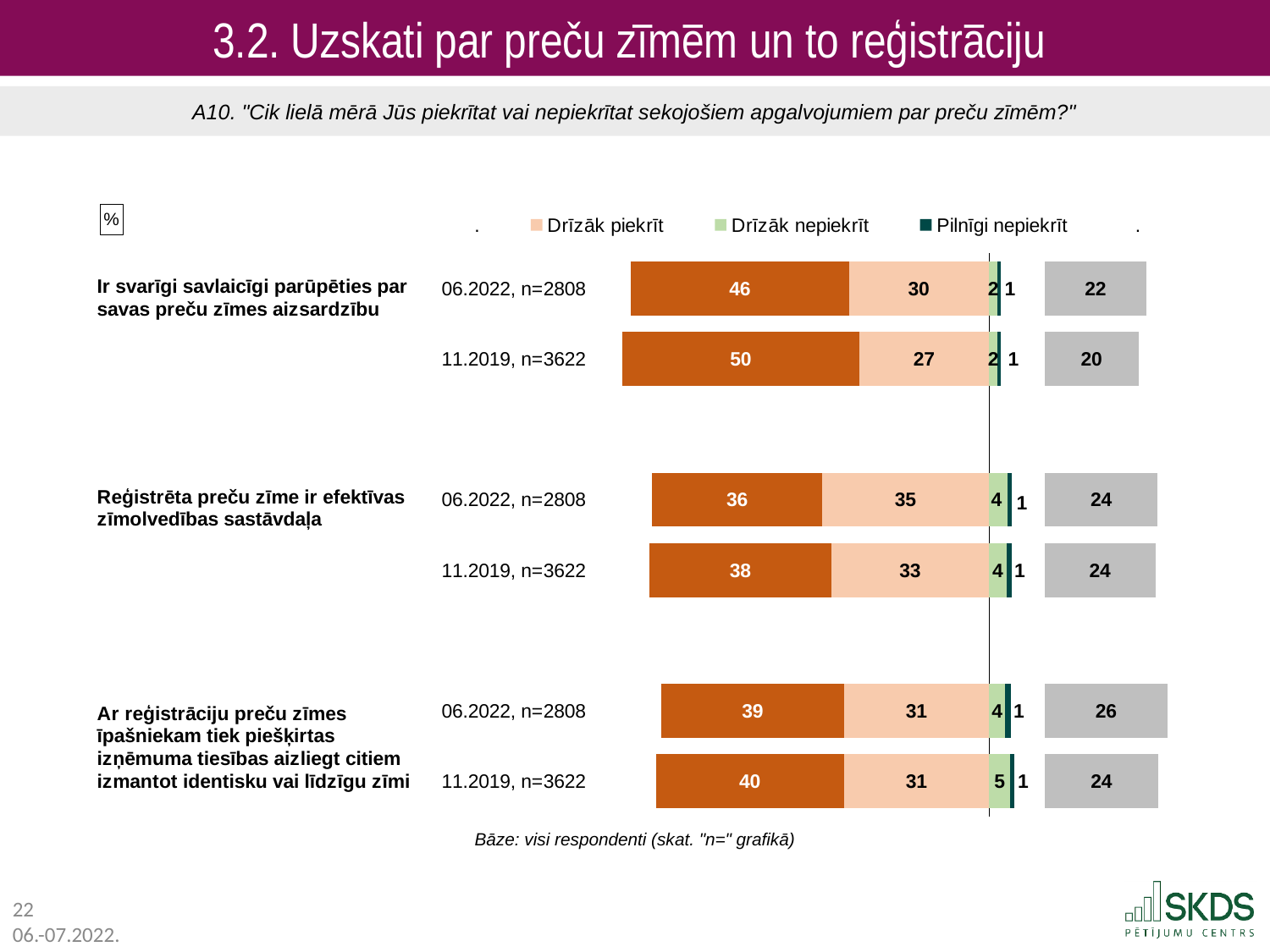
What is the value of the grey segment for "Ar reģistrāciju preču zīmes īpašniekam tiek piešķirtas izņēmuma tiesības aizliegt citiem izmantot identisku vai līdzīgu zīmi" in 06.2022, n=2808? 26 What type of chart is shown on the slide? Stacked bar chart What is the "Drīzāk piekrīt" value for "Ir svarīgi savlaicīgi parūpēties par savas preču zīmes aizsardzību" in 06.2022, n=2808? 30 How many stacked bars are shown in the chart? 6 For "Reģistrēta preču zīme ir efektīvas zīmolvedības sastāvdaļa", what is the difference between the "Drīzāk piekrīt" values in 06.2022 and 11.2019? 2 What is the "Drīzāk nepiekrīt" value for "Ar reģistrāciju preču zīmes īpašniekam tiek piešķirtas izņēmuma tiesības aizliegt citiem izmantot identisku vai līdzīgu zīmi" in 11.2019, n=3622? 5 Among the 06.2022, n=2808 bars, which statement has the highest "Drīzāk piekrīt" value? Reģistrēta preču zīme ir efektīvas zīmolvedības sastāvdaļa What is the "Drīzāk piekrīt" value for "Reģistrēta preču zīme ir efektīvas zīmolvedības sastāvdaļa" in 11.2019, n=3622? 33 What is the total of all segments in the bar for "Reģistrēta preču zīme ir efektīvas zīmolvedības sastāvdaļa" in 06.2022, n=2808? 100 Among the 11.2019, n=3622 bars, which statement has the lowest "Drīzāk nepiekrīt" value? Ir svarīgi savlaicīgi parūpēties par savas preču zīmes aizsardzību What is the "Pilnīgi nepiekrīt" value for "Reģistrēta preču zīme ir efektīvas zīmolvedības sastāvdaļa" in 06.2022, n=2808? 1 For "Ar reģistrāciju preču zīmes īpašniekam tiek piešķirtas izņēmuma tiesības aizliegt citiem izmantot identisku vai līdzīgu zīmi", which wave has the larger "Drīzāk nepiekrīt" value, 06.2022 or 11.2019? 11.2019